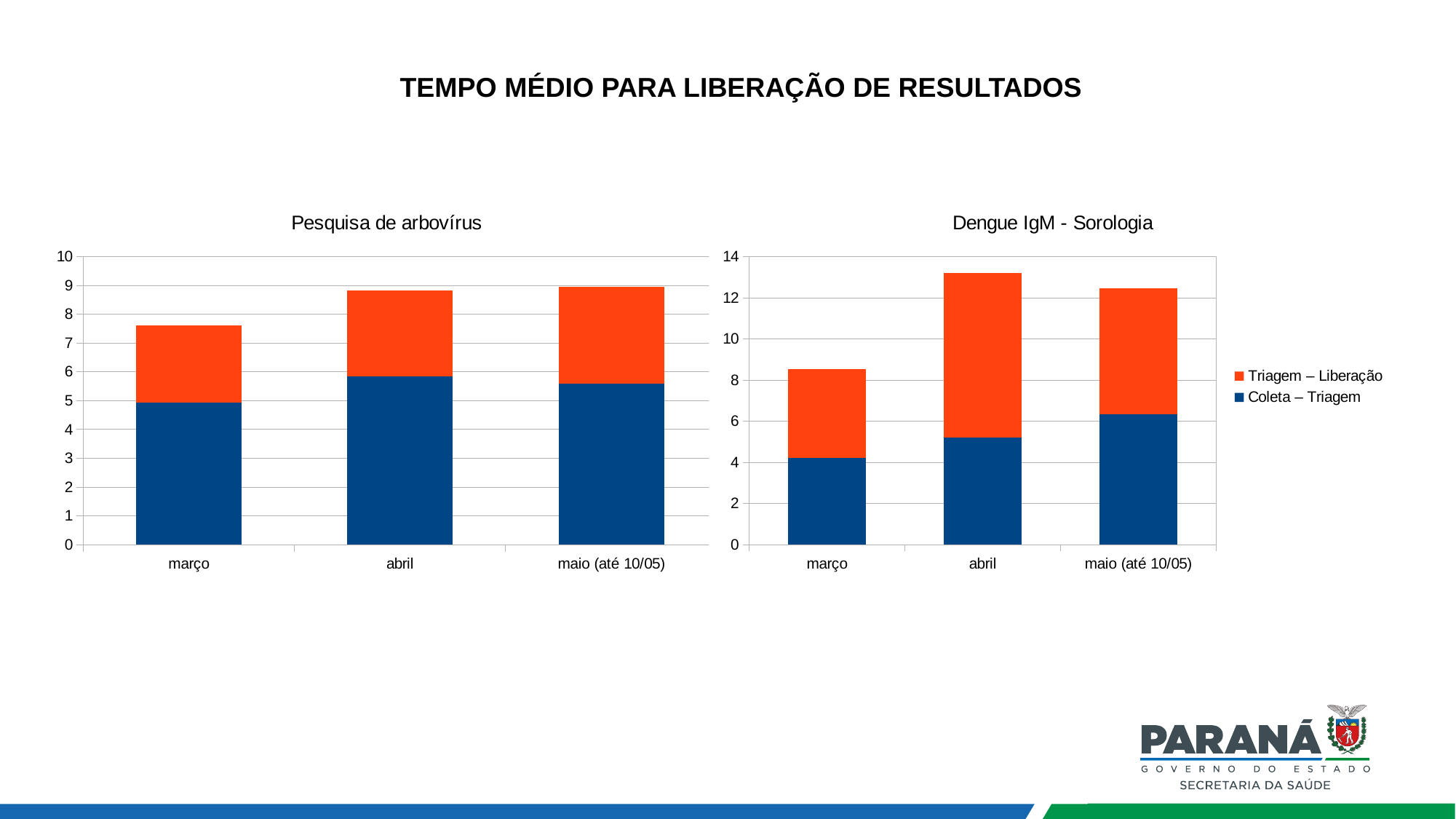
In the 'Pesquisa de arbovírus' chart, which month has the lowest total bar? março What kind of chart is the 'Pesquisa de arbovírus' chart? Bar chart How many series does the legend list for the charts on the slide? 2 In the 'Dengue IgM - Sorologia' chart, which month has the highest Coleta – Triagem value? maio (até 10/05) In the 'Pesquisa de arbovírus' chart, is the Coleta – Triagem value for abril greater or less than 5? greater In the 'Dengue IgM - Sorologia' chart, is the Coleta – Triagem value for março greater or less than 6? less In the 'Dengue IgM - Sorologia' chart, is the total value for abril greater or less than 12? greater In the 'Dengue IgM - Sorologia' chart, which month has the highest total bar? abril In the 'Dengue IgM - Sorologia' chart, does the Coleta – Triagem value rise or fall from março to maio (até 10/05)? rise In the 'Dengue IgM - Sorologia' chart, which month has the lowest total bar? março How many categories are shown on the x axis of the 'Dengue IgM - Sorologia' chart? 3